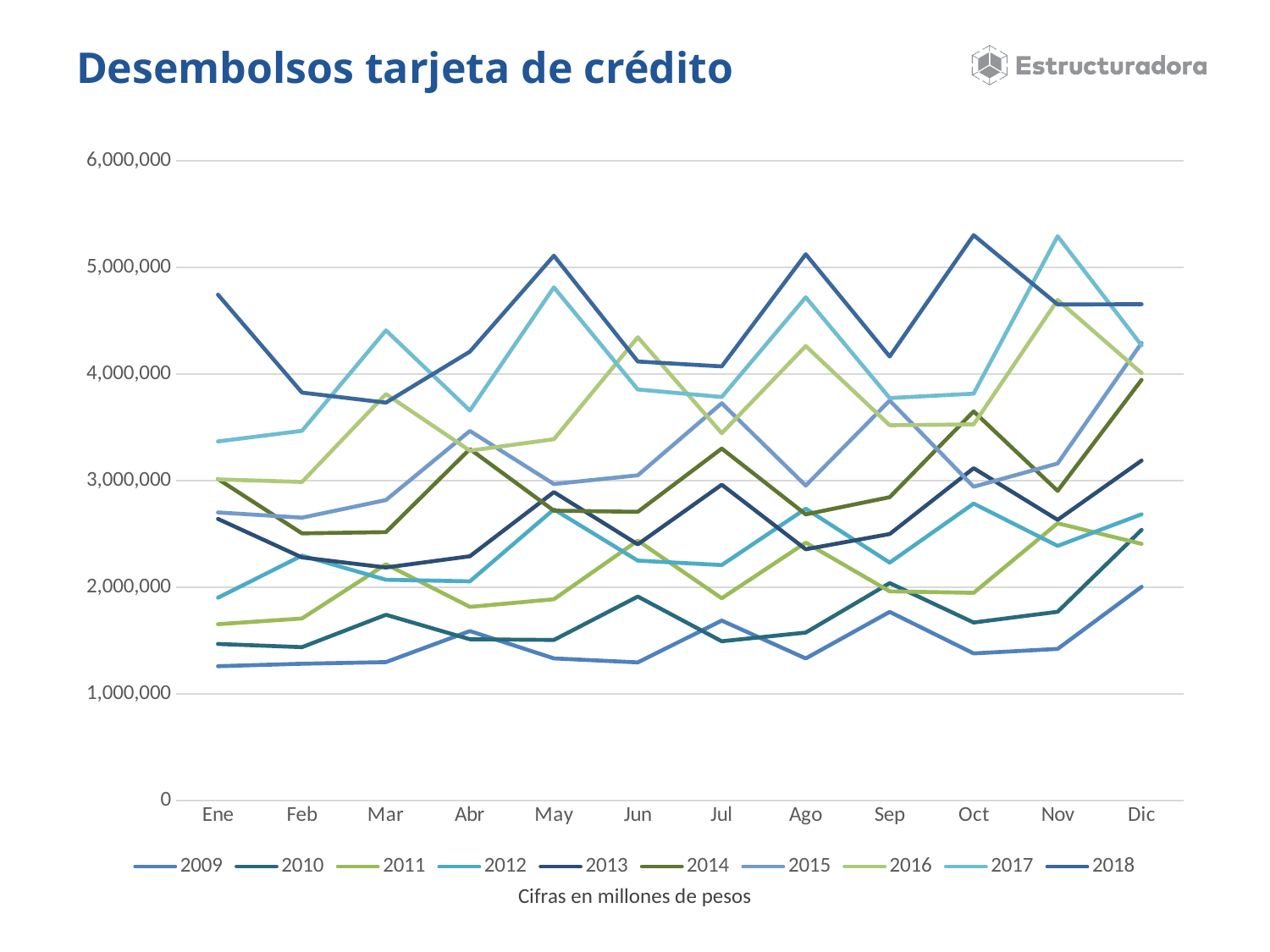
How many months are shown along the x axis? 12 Is the highest value plotted for Nov greater or less than 5,000,000? greater Does any line on the chart reach 6,000,000? no How many series does the legend list? 10 What is the title of the chart? Desembolsos tarjeta de crédito Is the highest value plotted for Oct greater or less than 5,000,000? greater Does the lowest line on the chart end higher or lower in Dic than it starts in Ene? higher What kind of chart is shown on the slide? line chart What note is printed below the legend about the units of the figures? Cifras en millones de pesos